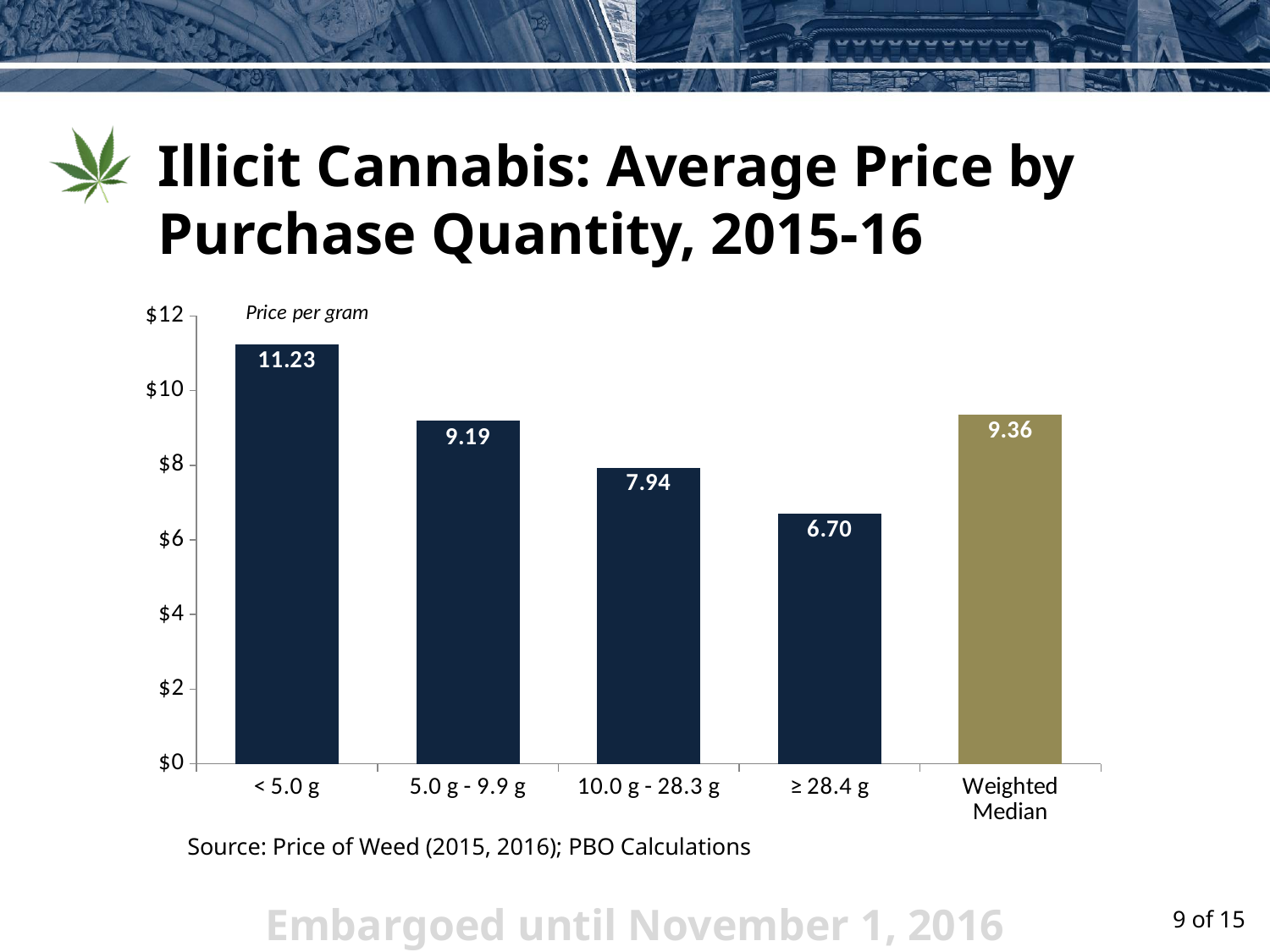
Which purchase quantity category has the highest average price per gram? < 5.0 g What is the average price per gram for purchases of less than 5.0 g? 11.23 What is the average price per gram for the 10.0 g - 28.3 g purchase quantity? 7.94 What is the source cited below the chart? Price of Weed (2015, 2016); PBO Calculations Is the value for 10.0 g - 28.3 g greater or less than $8? less What kind of chart is shown on the slide? Bar chart Do the average prices rise or fall as the purchase quantity increases across the four quantity categories? Fall Which purchase quantity category has the lowest average price per gram? ≥ 28.4 g What is the value shown for the Weighted Median bar? 9.36 Which is larger: the price per gram for 5.0 g - 9.9 g or the Weighted Median? Weighted Median How many bars are shown in the chart? 5 What is the difference between the price per gram for < 5.0 g and for ≥ 28.4 g? 4.53